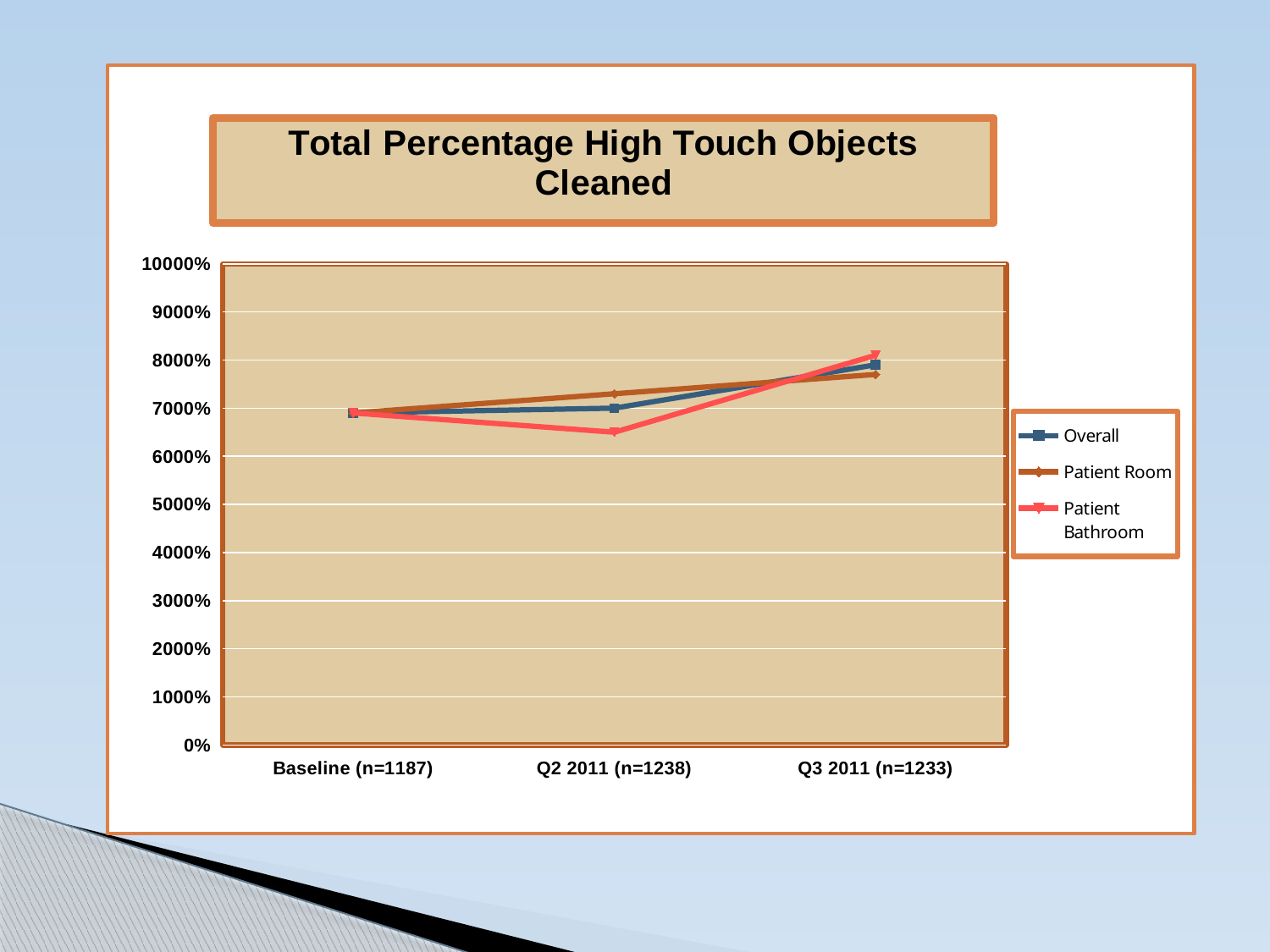
What is the title of the chart? Total Percentage High Touch Objects Cleaned Which series is drawn in red? Patient Bathroom At Q3 2011 (n=1233), which is larger: Patient Bathroom or Patient Room? Patient Bathroom What kind of chart is shown on the slide? line chart Is the value for Patient Room at Q2 2011 (n=1238) greater or less than 7000%? greater Does the Overall series rise or fall from Baseline (n=1187) to Q3 2011 (n=1233)? rise Is the value for Patient Bathroom at Q2 2011 (n=1238) greater or less than 7000%? less How many categories are shown on the x axis? 3 Is the value for Overall at Q3 2011 (n=1233) greater or less than 9000%? less At which category does the Patient Bathroom series reach its lowest value? Q2 2011 (n=1238) How many series does the legend list? 3 At Q2 2011 (n=1238), which is larger: Patient Room or Patient Bathroom? Patient Room